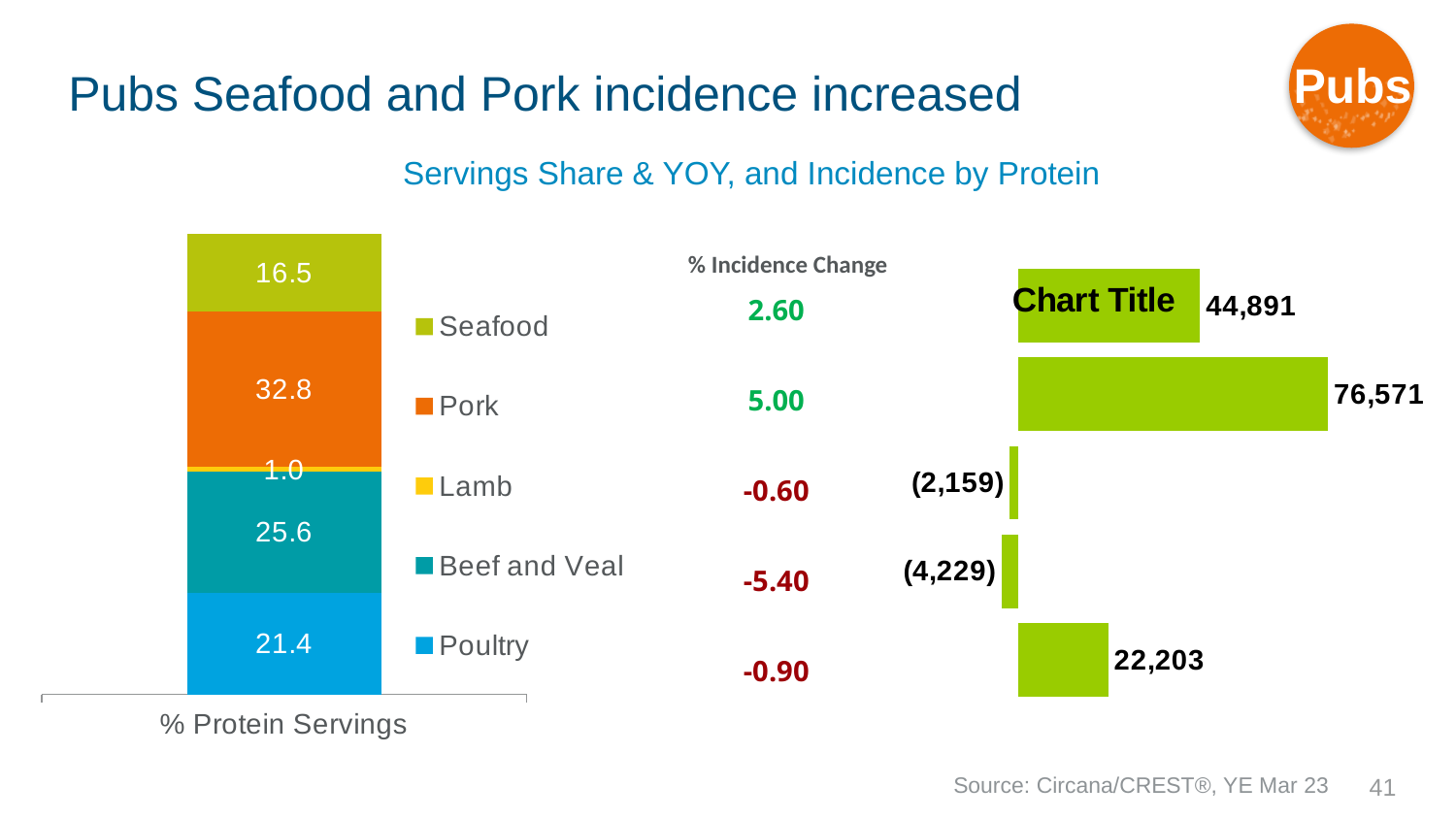
In the stacked bar chart on the left, which is larger, the Poultry value or the Beef and Veal value? Beef and Veal In the stacked bar chart on the left, which protein has the smallest share of servings? Lamb In the stacked bar chart on the left, what is the value for Beef and Veal? 25.6 In the stacked bar chart on the left, which protein has the largest share of servings? Pork What kind of chart is the chart on the left? Stacked bar chart How many series does the legend of the stacked bar chart on the left list? 5 In the bar chart on the right titled 'Chart Title', what is the value of the largest bar? 76,571 In the bar chart on the right titled 'Chart Title', how many bars are plotted? 5 In the stacked bar chart on the left, what is the value for Pork? 32.8 What is the total of the stacked bar in the chart on the left? 97.3 In the stacked bar chart on the left, what is the difference between the Pork and Seafood values? 16.3 In the bar chart on the right titled 'Chart Title', what is the value of the bottom bar? 22,203